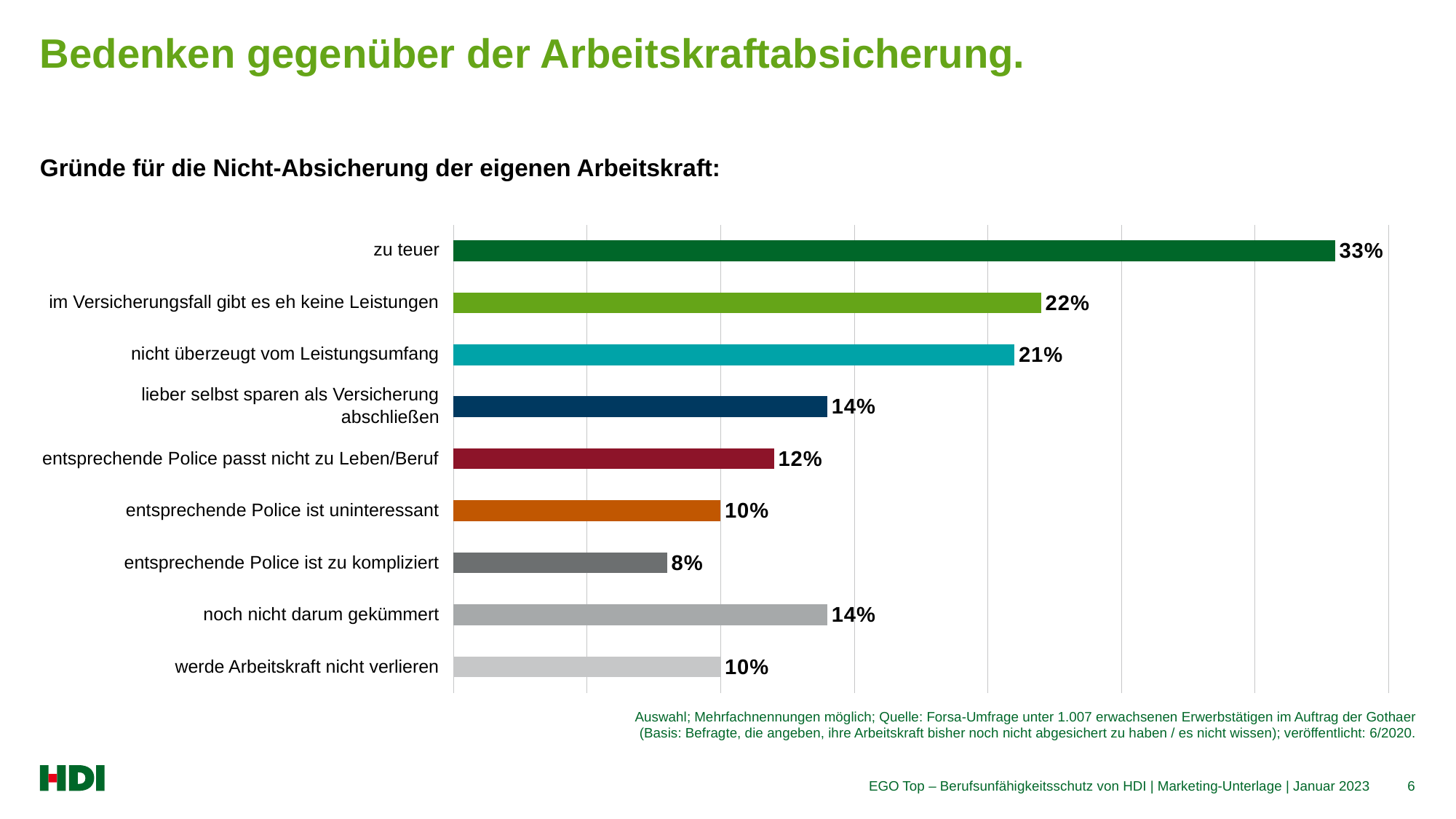
What percentage is shown for "entsprechende Police ist zu kompliziert"? 8% What is the value for "nicht überzeugt vom Leistungsumfang"? 21% What type of chart is shown on the slide? bar chart What percentage is shown for "zu teuer"? 33% Which reason has the highest percentage? zu teuer What is the difference between "entsprechende Police passt nicht zu Leben/Beruf" and "entsprechende Police ist uninteressant"? 2% What is the subtitle above the chart? Gründe für die Nicht-Absicherung der eigenen Arbeitskraft: What is the difference between "zu teuer" and "im Versicherungsfall gibt es eh keine Leistungen"? 11% How many reasons (bars) are shown in the chart? 9 Which reason has the lowest percentage? entsprechende Police ist zu kompliziert What is the value for "noch nicht darum gekümmert"? 14% Which is larger: "lieber selbst sparen als Versicherung abschließen" or "entsprechende Police ist uninteressant"? lieber selbst sparen als Versicherung abschließen